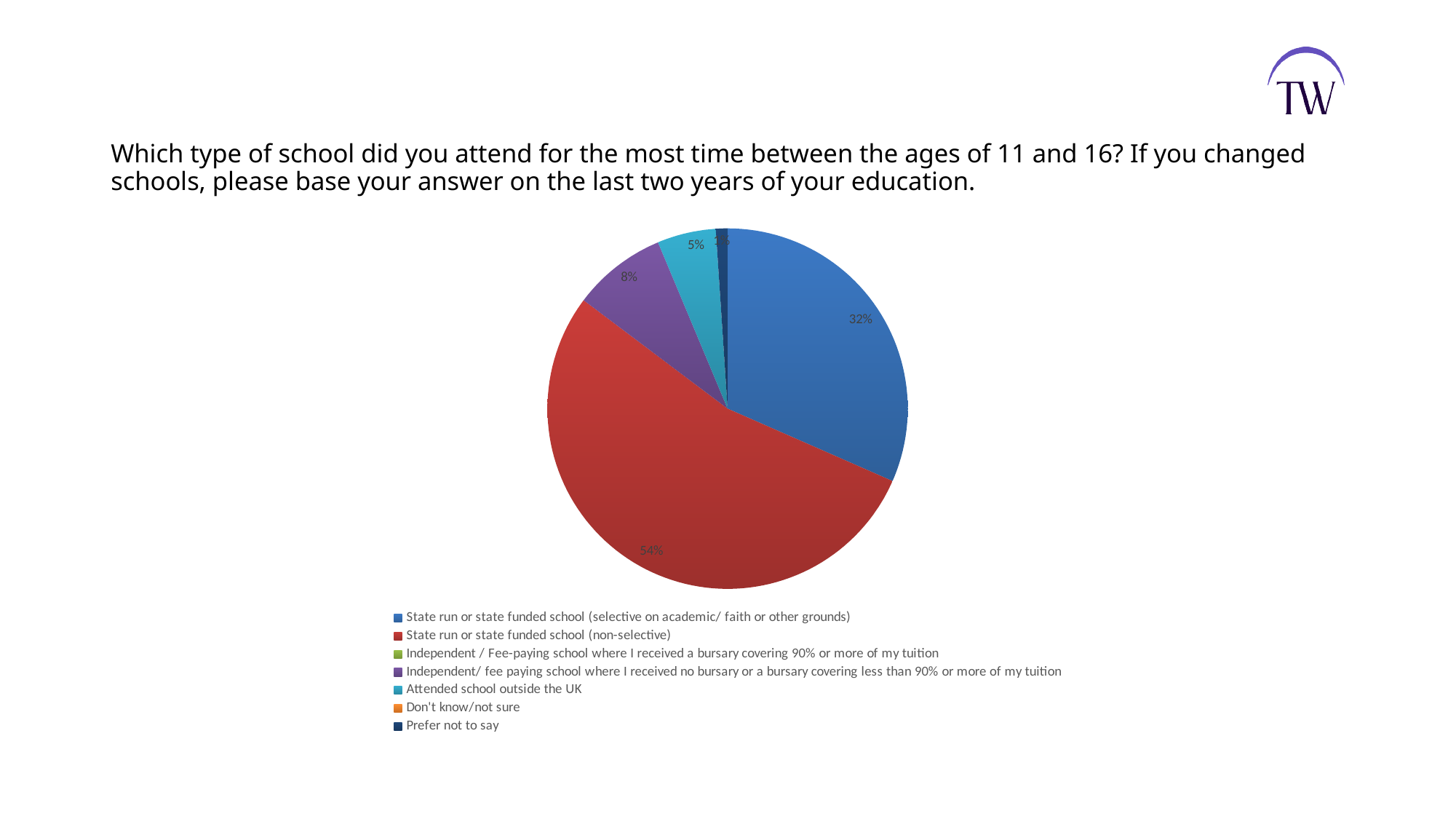
What colour is the slice for state run or state funded school (non-selective)? Red Which is larger: the share for state run or state funded school (selective) or the share for attended school outside the UK? State run or state funded school (selective) What is the difference in percentage points between the non-selective state school share (54%) and the selective state school share (32%)? 22 percentage points What kind of chart is shown on the slide? Pie chart What percentage of respondents attended a state run or state funded school (selective on academic/ faith or other grounds)? 32% What percentage of respondents attended a state run or state funded school (non-selective)? 54% How many categories are listed in the legend? 7 What percentage of respondents attended school outside the UK? 5% What is the difference in percentage points between the independent school with no bursary share (8%) and the attended school outside the UK share (5%)? 3 percentage points What share of the pie is for an independent/ fee paying school where the respondent received no bursary or a bursary covering less than 90% of tuition? 8% Which is larger: the share for independent/ fee paying school with no bursary or the share for attended school outside the UK? Independent/ fee paying school with no bursary Which category has the largest slice of the pie? State run or state funded school (non-selective)